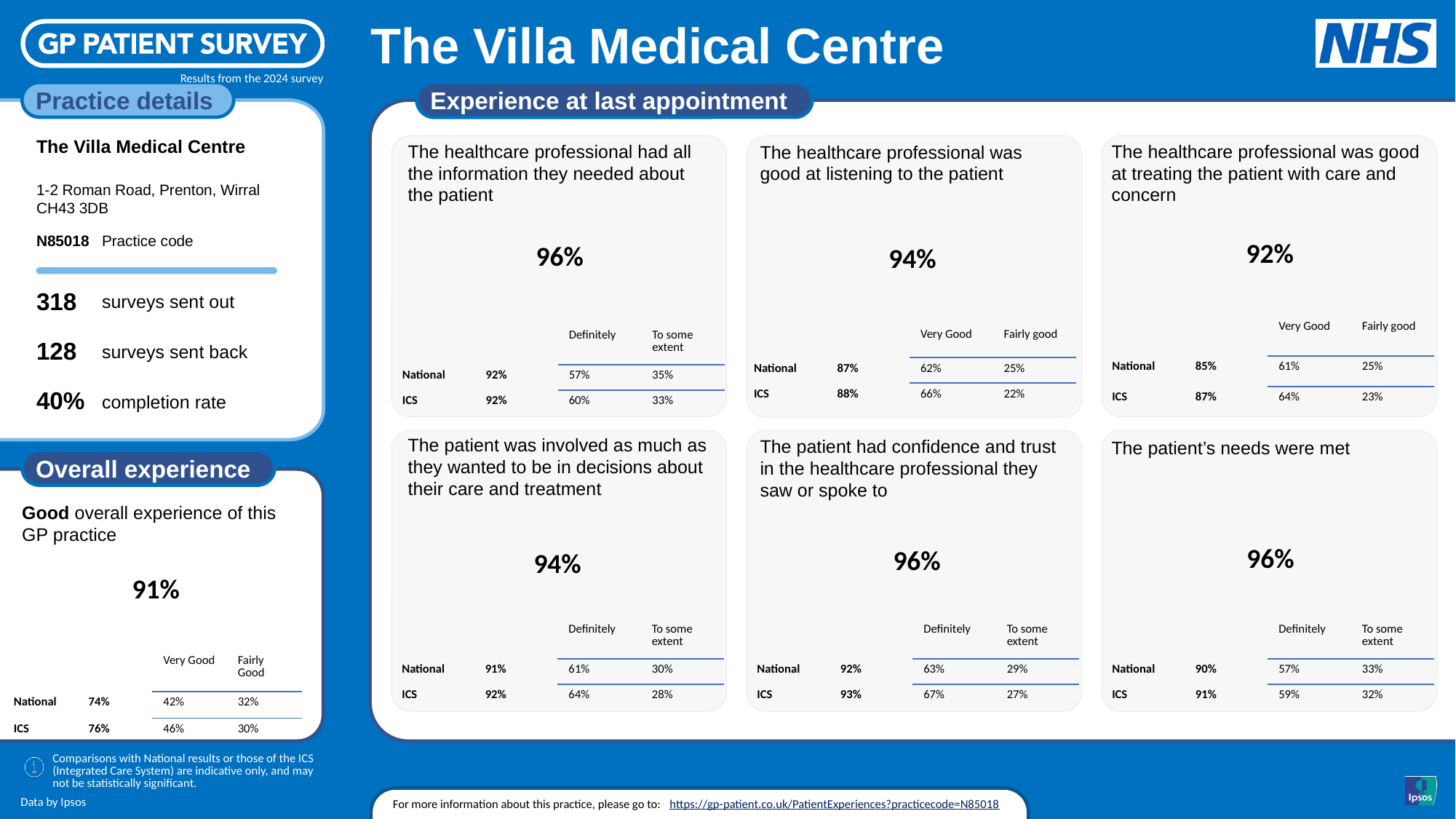
In the 'The patient had confidence and trust in the healthcare professional they saw or spoke to' panel, what is the National 'Definitely' value? 63% In the 'Good overall experience of this GP practice' panel, what is the ICS 'Very Good' value? 46% How many question panels are shown under the 'Experience at last appointment' heading? 6 In the 'The healthcare professional had all the information they needed about the patient' panel, what is the practice's headline percentage? 96% In the 'The patient was involved as much as they wanted to be in decisions about their care and treatment' panel, which is larger, the National value or the ICS value? ICS Among the six 'Experience at last appointment' panels, which question has the lowest practice headline percentage? The healthcare professional was good at treating the patient with care and concern In the 'The healthcare professional was good at treating the patient with care and concern' panel, what is the National value? 85% In the 'Good overall experience of this GP practice' panel, what is the National value? 74% In the 'The healthcare professional was good at listening to the patient' panel, what is the ICS 'Very Good' value? 66% In the 'The patient's needs were met' panel, what is the difference between the practice's 96% and the ICS 91%? 5% In the 'Good overall experience of this GP practice' panel, what is the practice's headline percentage? 91% In the 'Good overall experience of this GP practice' panel, what is the difference between the practice's 91% and the National 74%? 17%